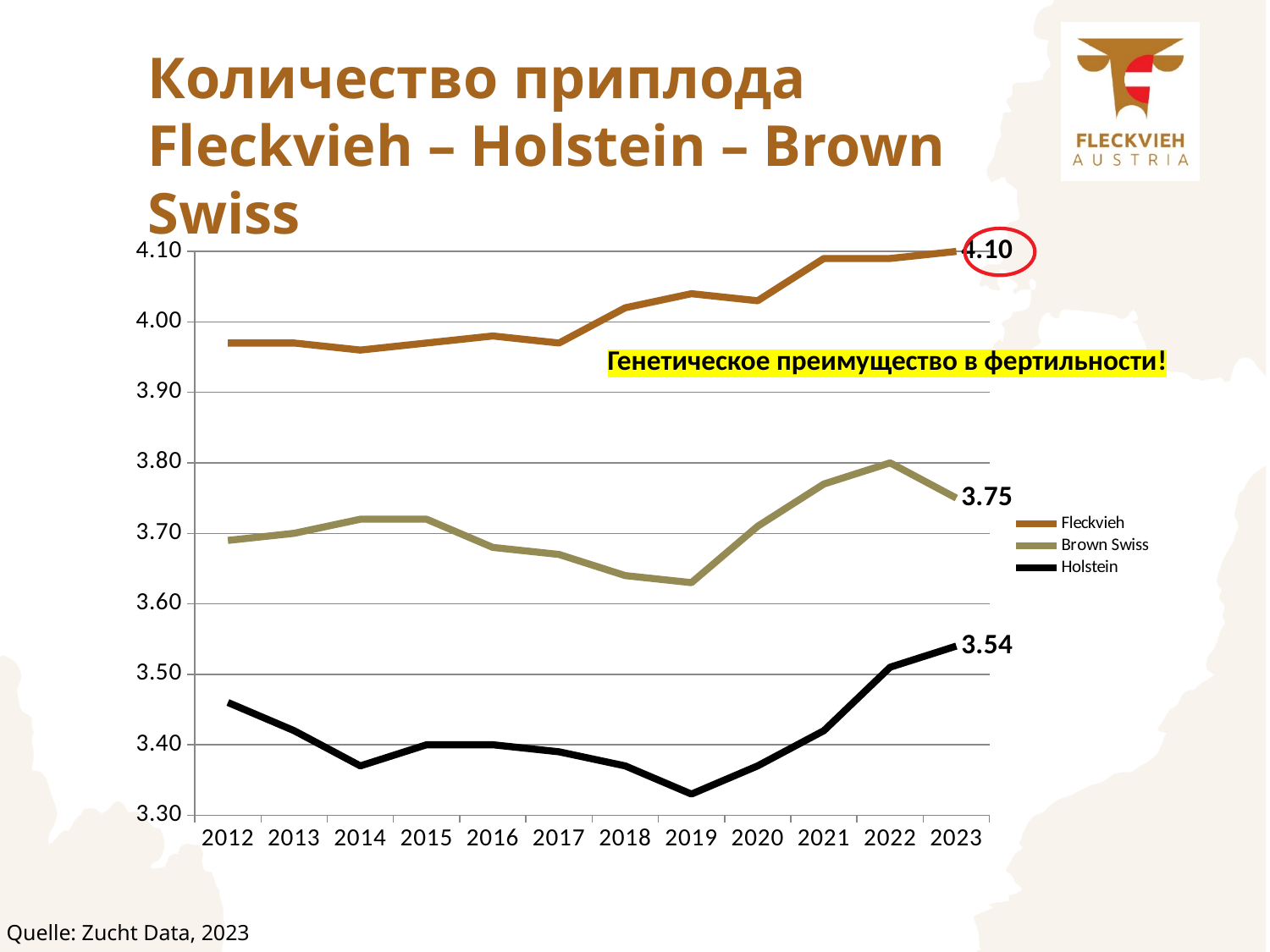
What is the value for Brown Swiss in 2023? 3.75 What is the value for Fleckvieh in 2023? 4.10 Is the value for Holstein in 2019 greater or less than 3.40? less What is the value for Holstein in 2023? 3.54 Which series has the highest value in 2023? Fleckvieh Which series has the lowest value in 2023? Holstein What kind of chart is shown on the slide? line chart How many series does the legend list? 3 Is the value for Fleckvieh in 2021 greater or less than 4.00? greater What is the difference between the Fleckvieh and Holstein values in 2023? 0.56 How many years are shown on the x axis? 12 What is the difference between the Brown Swiss and Holstein values in 2023? 0.21